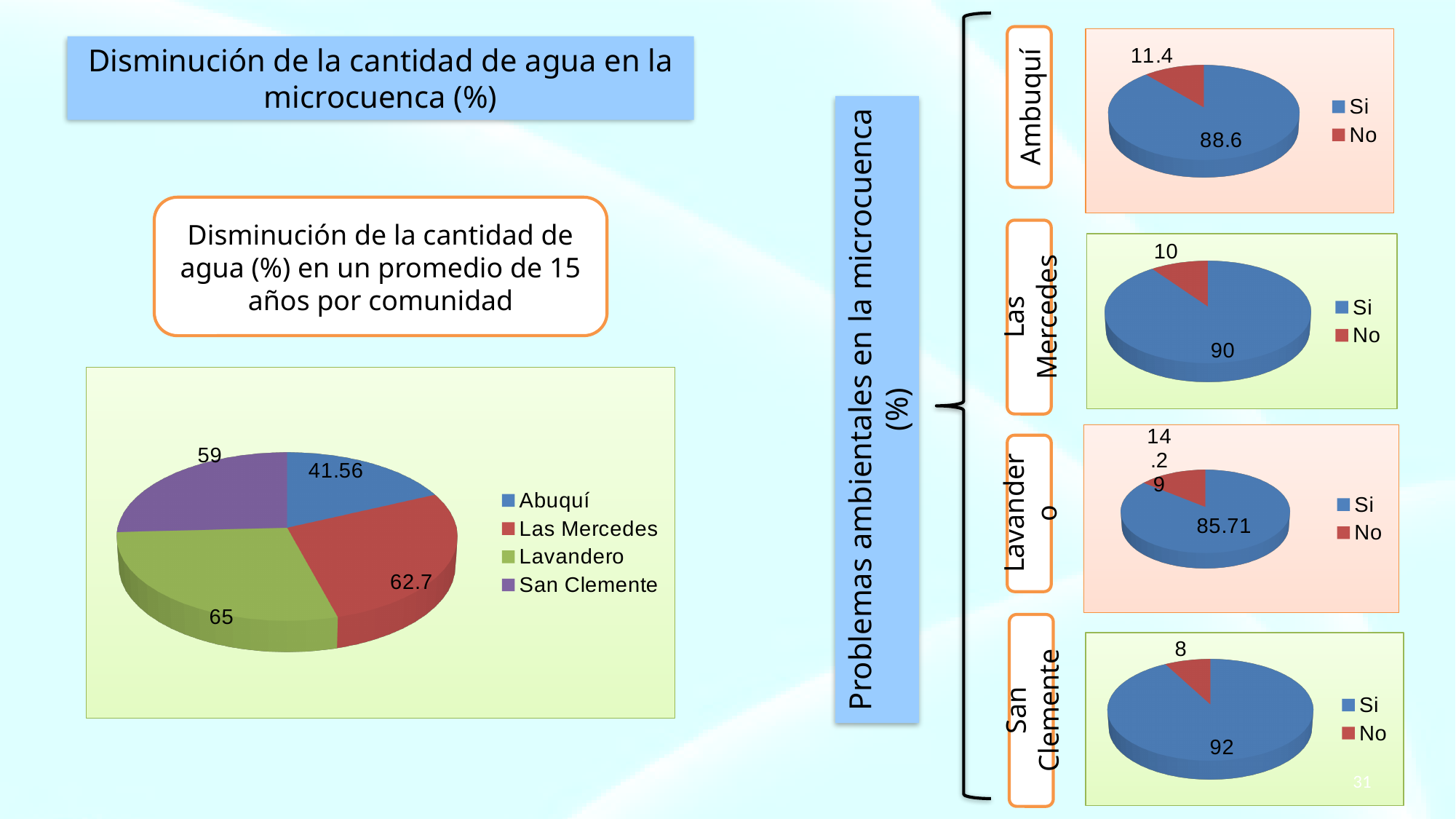
In the left pie chart 'Disminución de la cantidad de agua en la microcuenca (%)', what is the value for Lavandero? 65 In the San Clemente pie chart on the right, what is the difference between 'Si' and 'No'? 84 In the Ambuquí pie chart on the right, what is the value for 'No'? 11.4 Among the four small pie charts on the right, which community has the highest 'Si' value? San Clemente In the left pie chart 'Disminución de la cantidad de agua en la microcuenca (%)', what is the difference between the values for Las Mercedes and San Clemente? 3.7 In the left pie chart 'Disminución de la cantidad de agua en la microcuenca (%)', which community has the lowest value? Abuquí What kind of chart is the large chart on the left of the slide? Pie chart In the left pie chart 'Disminución de la cantidad de agua en la microcuenca (%)', what is the value for Abuquí? 41.56 How many categories does the legend of the left pie chart 'Disminución de la cantidad de agua en la microcuenca (%)' list? 4 In the left pie chart 'Disminución de la cantidad de agua en la microcuenca (%)', which community has the highest value? Lavandero In the Las Mercedes pie chart on the right, which is larger, 'Si' or 'No'? Si In the Lavandero pie chart on the right, what is the value for 'Si'? 85.71